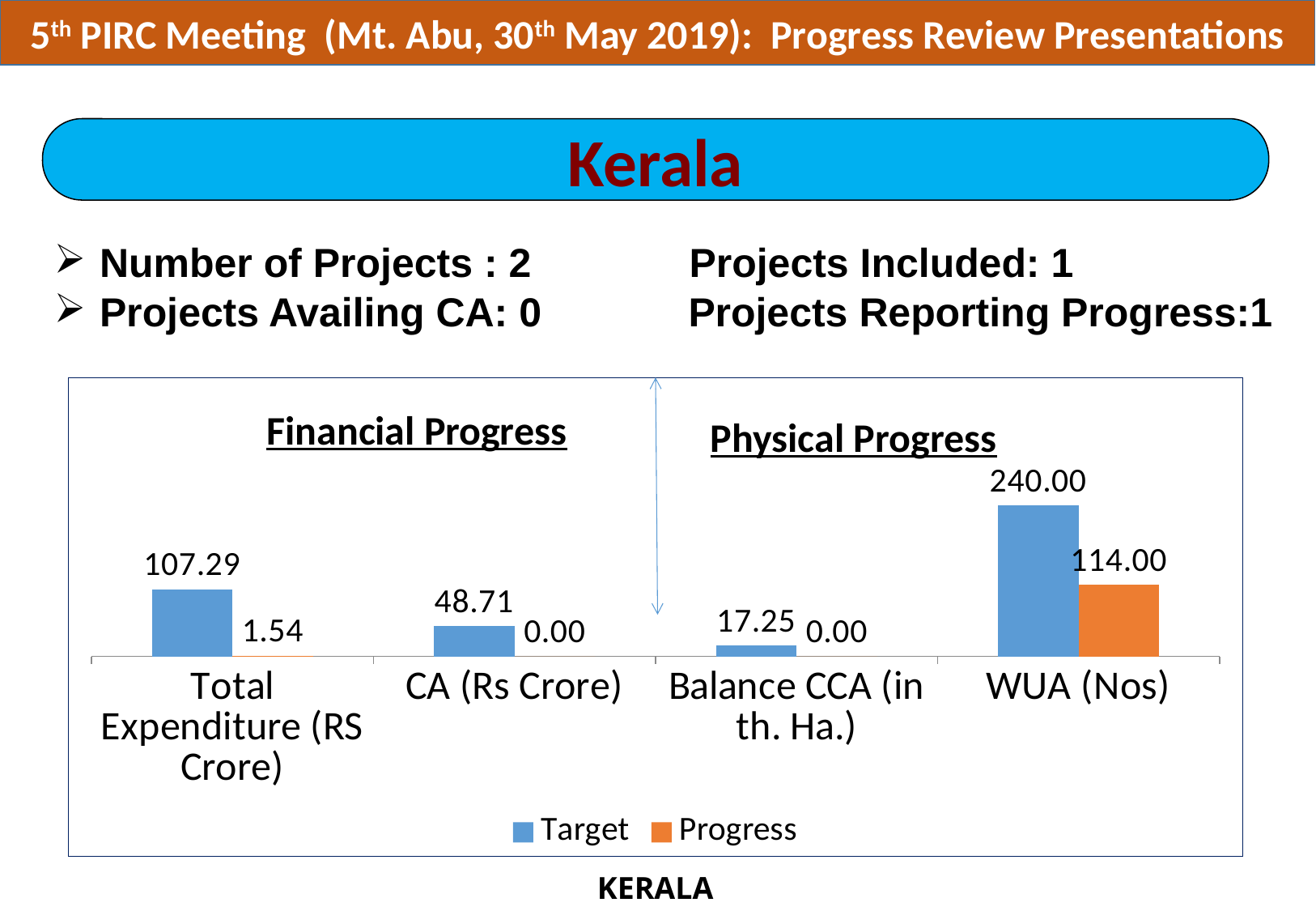
What is the Progress value for WUA (Nos)? 114.00 How many categories are shown on the x axis of the chart? 4 What kind of chart is shown on the slide? bar chart Which category has the lowest Target value? Balance CCA (in th. Ha.) What is the Target value for Total Expenditure (RS Crore)? 107.29 What is the Target value for Balance CCA (in th. Ha.)? 17.25 What is the difference between the Target and Progress values for WUA (Nos)? 126.00 What is the Progress value for Total Expenditure (RS Crore)? 1.54 Which category has the highest Target value? WUA (Nos) How many series does the chart legend list? 2 Is the Target value for Total Expenditure (RS Crore) larger or smaller than the Target value for CA (Rs Crore)? larger What is the Target value for CA (Rs Crore)? 48.71